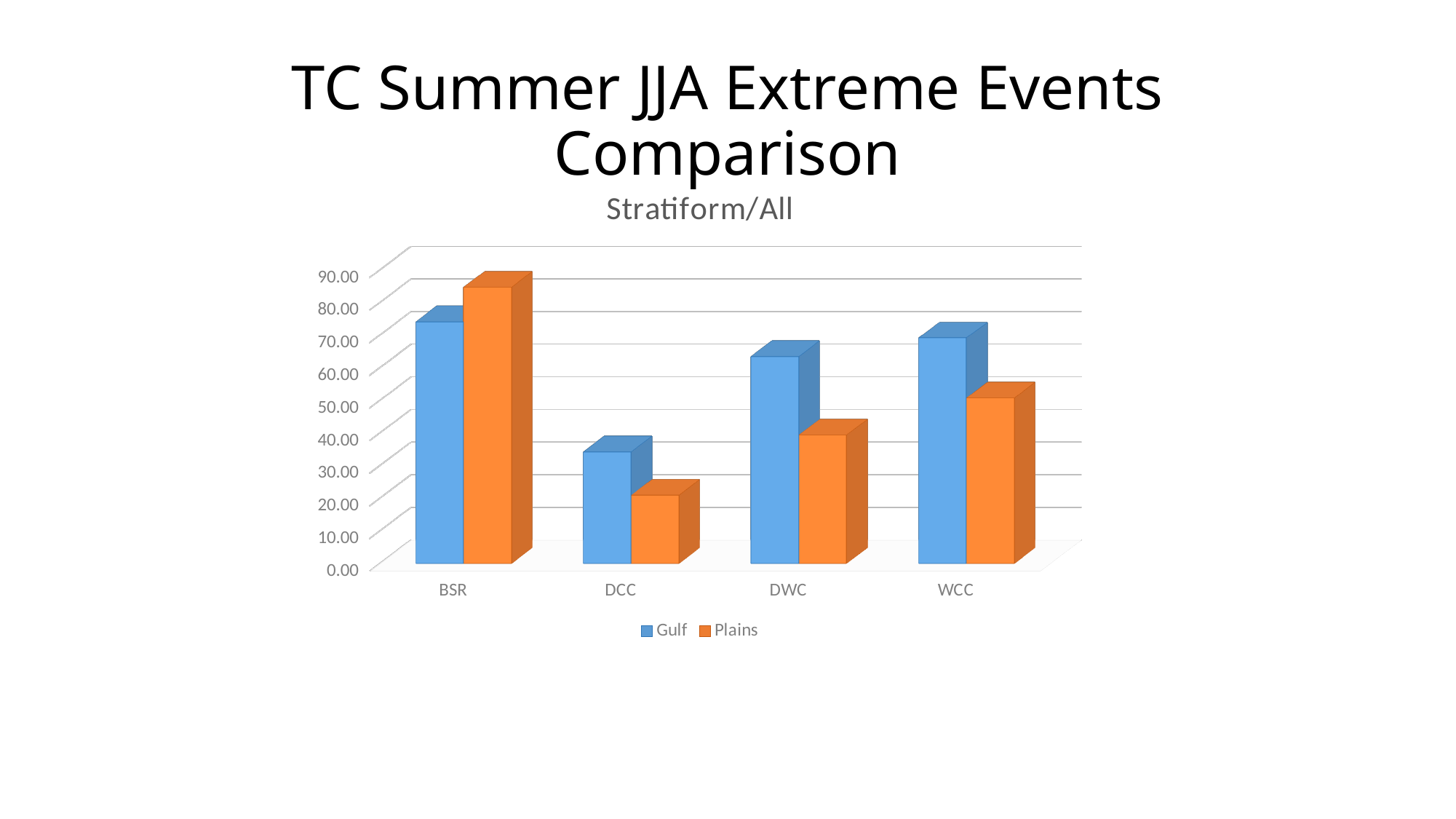
Which category has the highest Gulf value? BSR Which category has the highest Plains value? BSR Which category has the lowest Plains value? DCC Is the Gulf value for DWC greater or less than 70.00? less Is the Plains value for BSR greater or less than 80.00? greater For DCC, which series has the larger value, Gulf or Plains? Gulf Which category has the lowest Gulf value? DCC What is the title shown directly above the chart? Stratiform/All How many series does the legend list? 2 How many categories are shown on the x axis of the chart? 4 What kind of chart is shown on the slide? Bar chart For BSR, which series has the larger value, Gulf or Plains? Plains